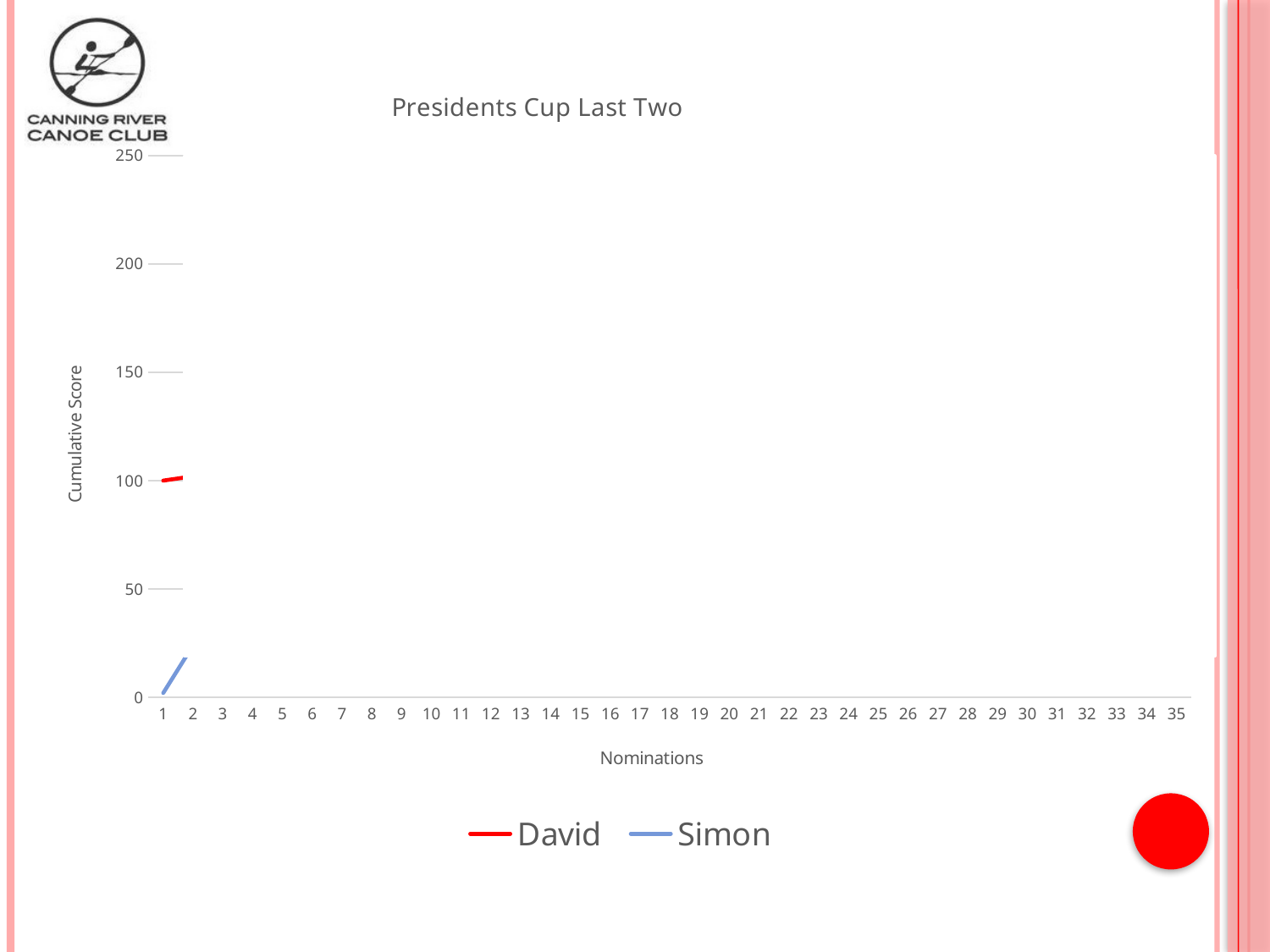
Which series has the lowest cumulative score shown on the chart? Simon What is the label on the vertical axis? Cumulative Score Is the value for David at nomination 2 greater or less than 150? less How many series does the legend list? 2 What is the title of the chart? Presidents Cup Last Two Does Simon's cumulative score rise or fall from nomination 1 to nomination 2? rise Is the value for David at nomination 1 greater or less than 50? greater Is the value for Simon at nomination 2 greater or less than 50? less How many nomination values are marked along the x axis? 35 What kind of chart is shown on the slide? line chart At nomination 2, which series has the higher cumulative score, David or Simon? David Which series has the highest cumulative score shown on the chart? David